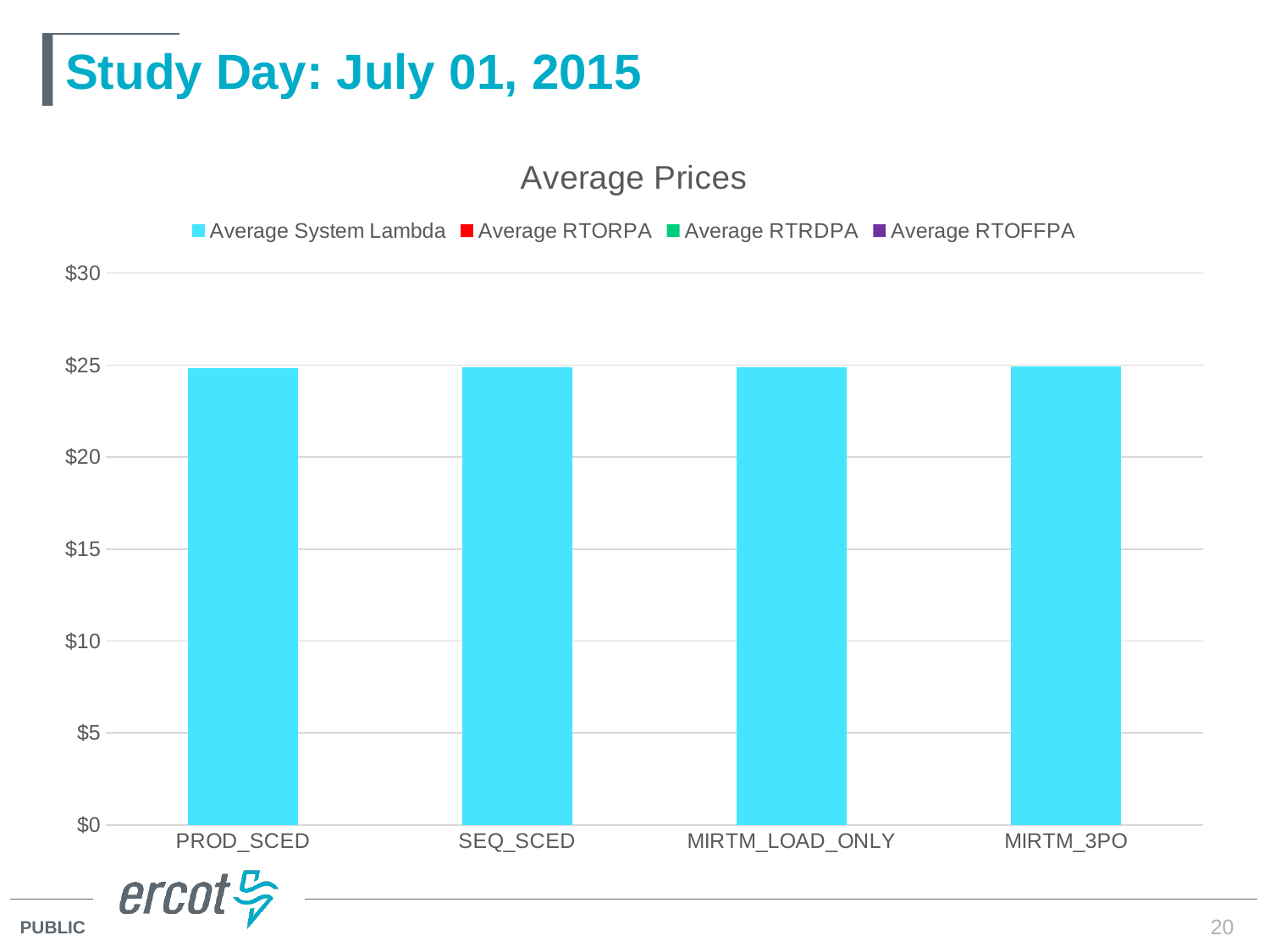
How many categories are shown on the x axis of the chart? 4 What kind of chart is shown on the slide? bar chart Which series is plotted in light blue according to the legend? Average System Lambda What is the title of the chart? Average Prices Is the value for PROD_SCED greater or less than $20? greater Is the value for MIRTM_LOAD_ONLY greater or less than $15? greater How many series does the chart's legend list? 4 What is the label of the first category on the x axis? PROD_SCED Is the value for SEQ_SCED greater or less than $30? less What is the highest value shown on the y axis? $30